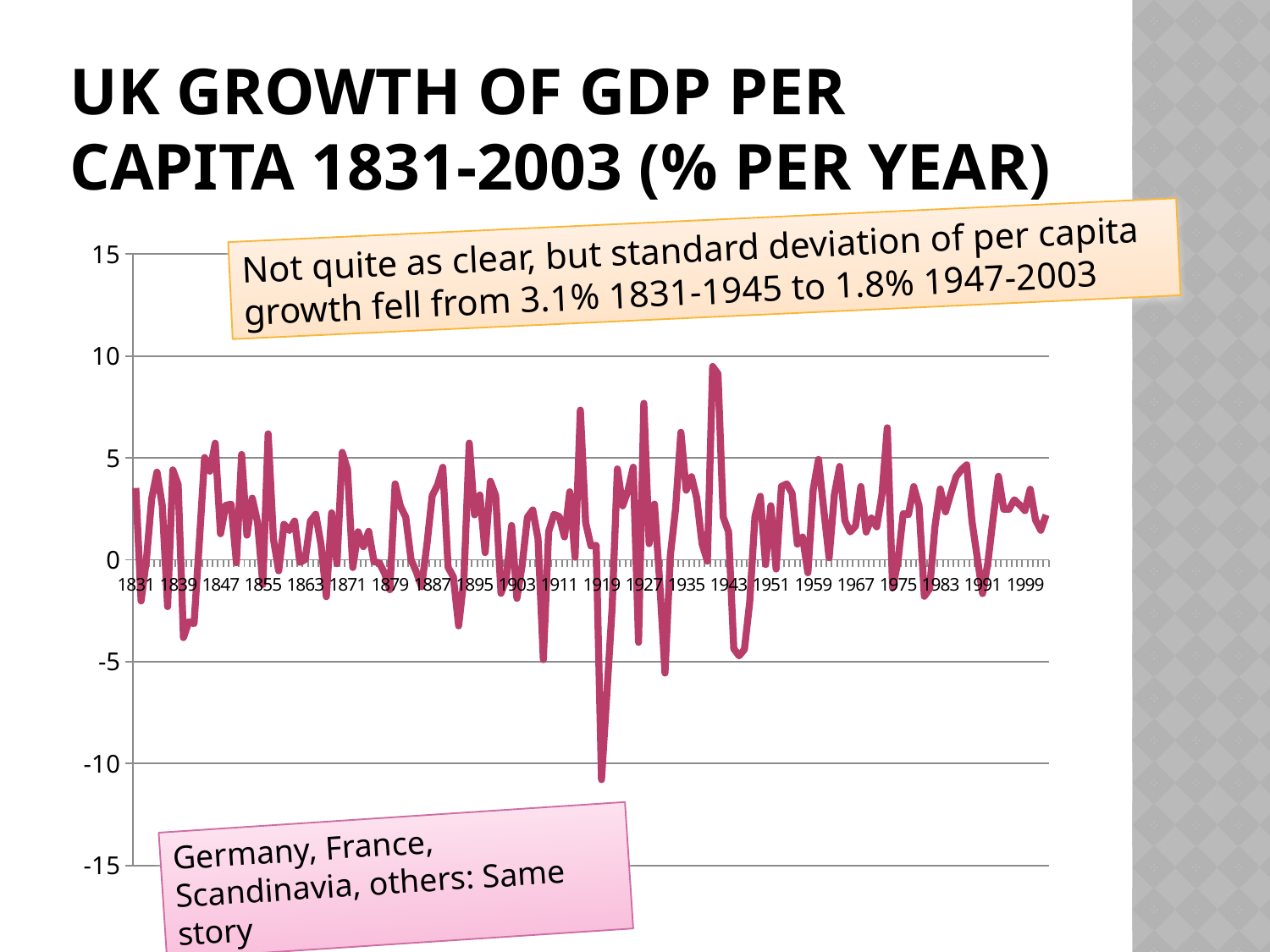
How many data series are plotted on the chart? 1 What is the title of the chart on the slide? UK Growth of GDP per Capita 1831-2003 (% per year) According to the text box on the slide, what did the standard deviation of per capita growth fall to for 1947-2003? 1.8% What kind of chart is shown on the slide? line chart Is the lowest value on the chart greater or less than -5? less Is the value for 1999 greater or less than 0? greater Is the highest value on the chart greater or less than 5? greater